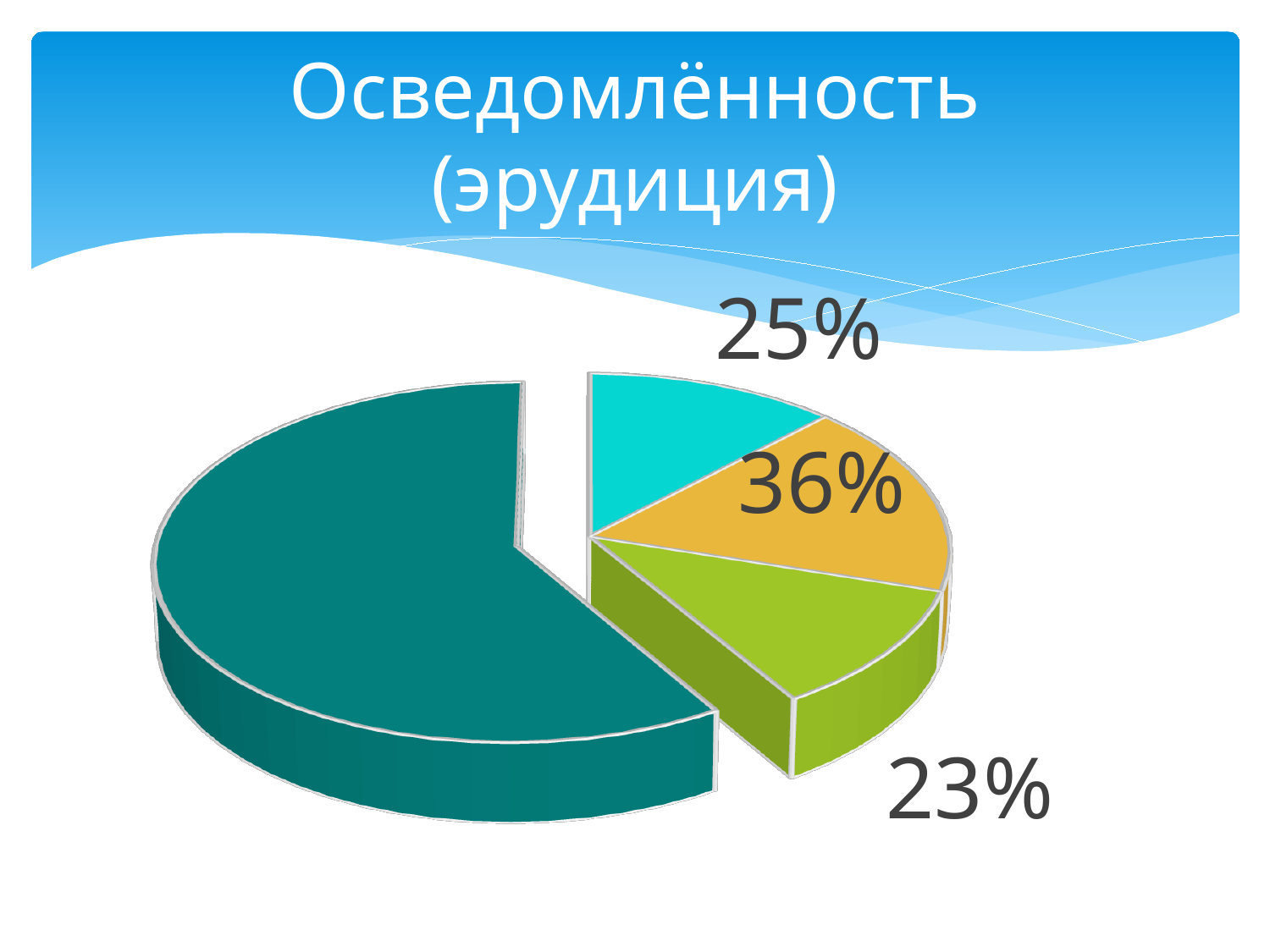
Which printed value is larger, 25% or 23%? 25% What is the difference between the printed values 36% and 23%? 13% Does the chart have a legend? No What is the smallest percentage value printed on the chart? 23% What is the largest percentage value printed on the chart? 36% How many percentage labels are printed on the pie chart? 3 How many slices does the pie chart have? 4 What kind of chart is shown on the slide? pie chart Which slice of the pie chart is the largest by area? the dark teal slice What is the title of the chart on the slide? Осведомлённость (эрудиция)